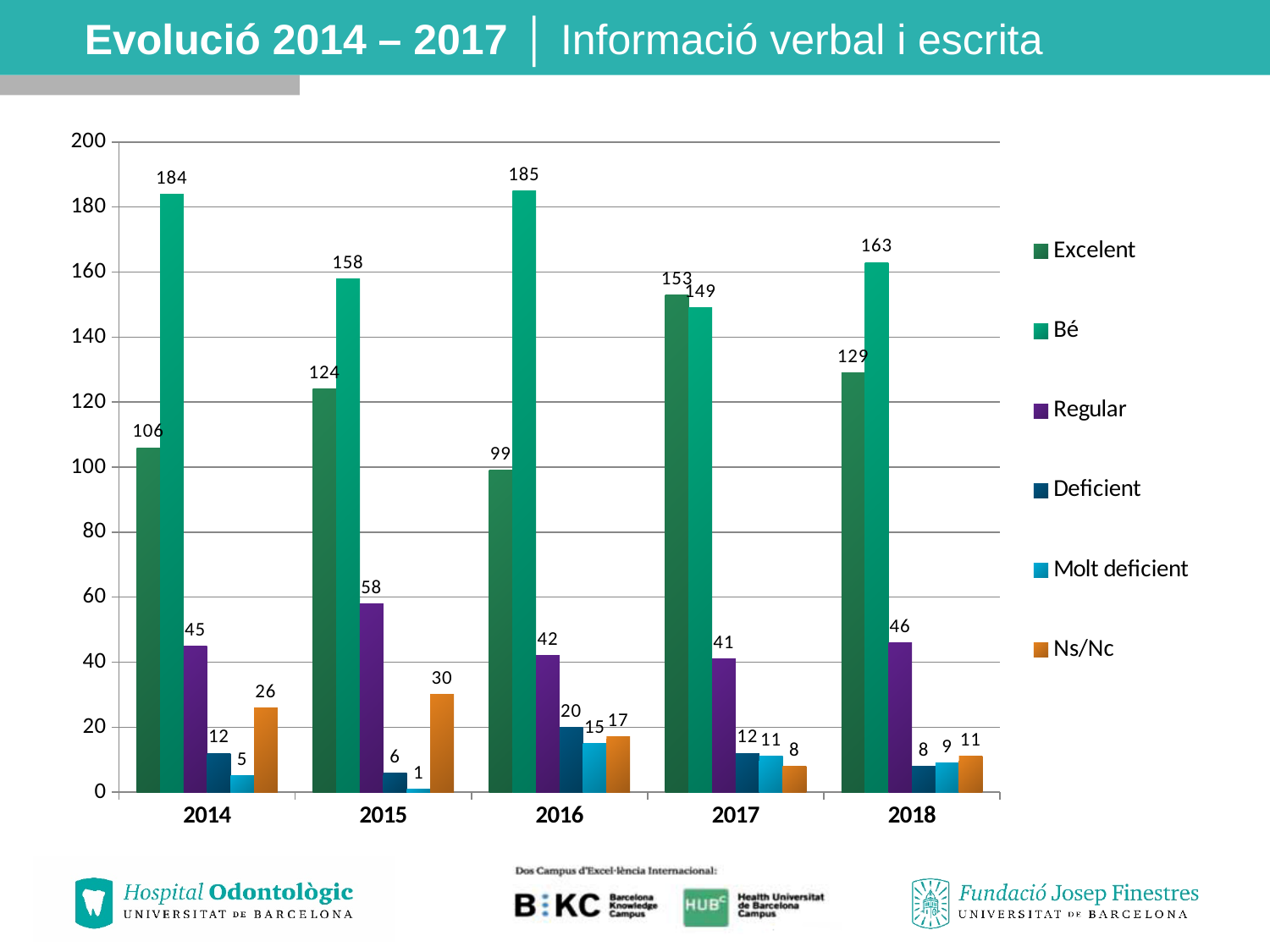
What is the value for Ns/Nc in 2016? 17 Does the Excelent value rise or fall from 2014 to 2015? Rise What is the value for Bé in 2014? 184 In which year is the Bé value highest? 2016 What kind of chart is shown on the slide? Bar chart How many series does the legend list? 6 What is the value for Excelent in 2017? 153 How many years are shown on the x axis? 5 In which year is the Molt deficient value lowest? 2015 Which is larger in 2017, Excelent or Bé? Excelent What is the difference between the Bé value in 2016 and the Bé value in 2018? 22 What is the value for Regular in 2015? 58